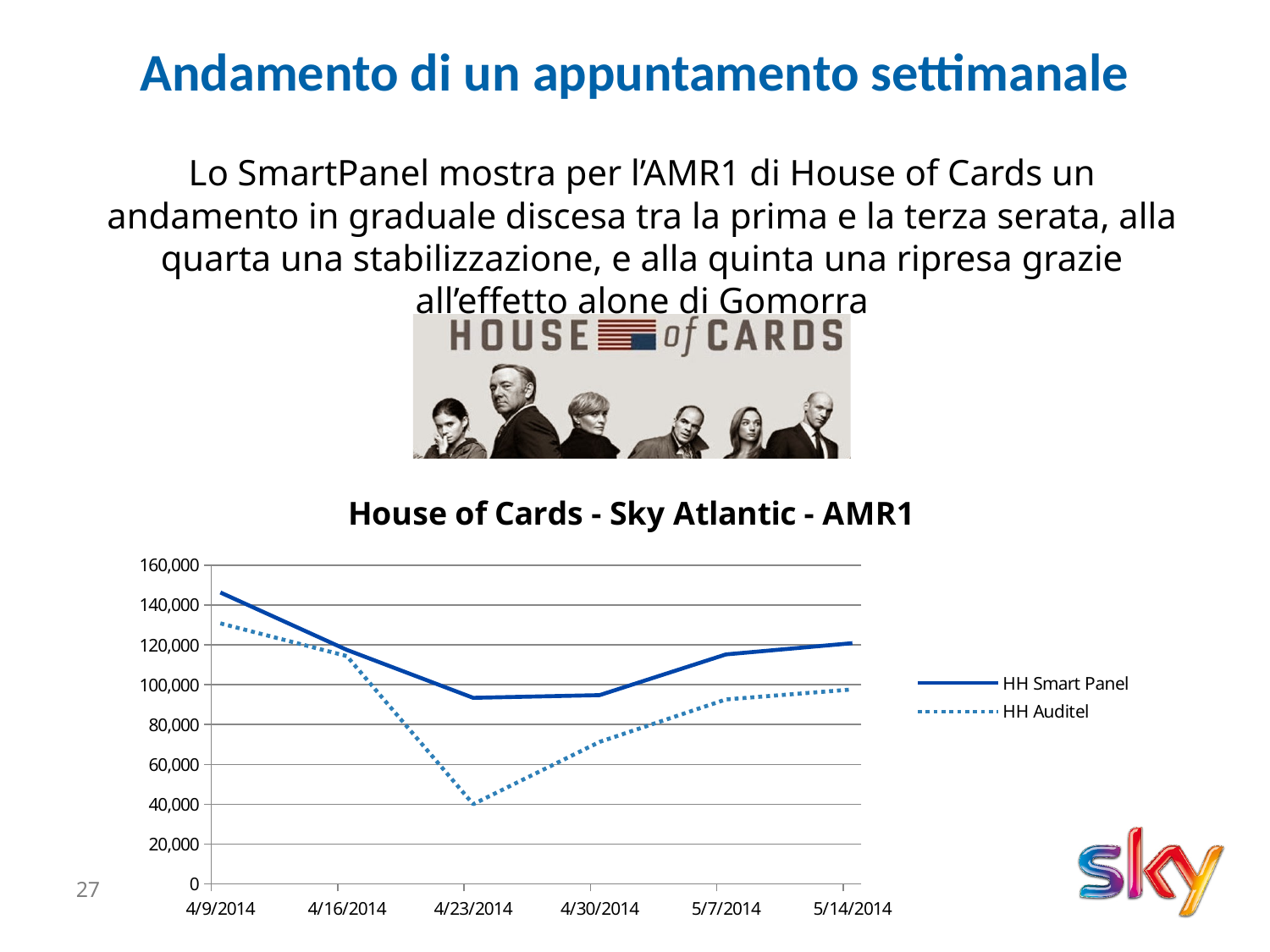
Does the HH Smart Panel series rise or fall between 4/9/2014 and 4/23/2014? fall Is the HH Smart Panel value for 4/9/2014 greater or less than 140,000? greater How many series does the chart legend list? 2 On 4/23/2014, which series has the larger value, HH Smart Panel or HH Auditel? HH Smart Panel Is the HH Smart Panel value for 5/14/2014 greater or less than 100,000? greater What is the title of the chart? House of Cards - Sky Atlantic - AMR1 Is the HH Auditel value for 4/23/2014 greater or less than 60,000? less What kind of chart is shown on the slide? line chart Which series is drawn with a dotted line? HH Auditel How many dates are shown on the x axis of the chart? 6 On which date is the HH Smart Panel value highest? 4/9/2014 On which date is the HH Auditel value lowest? 4/23/2014